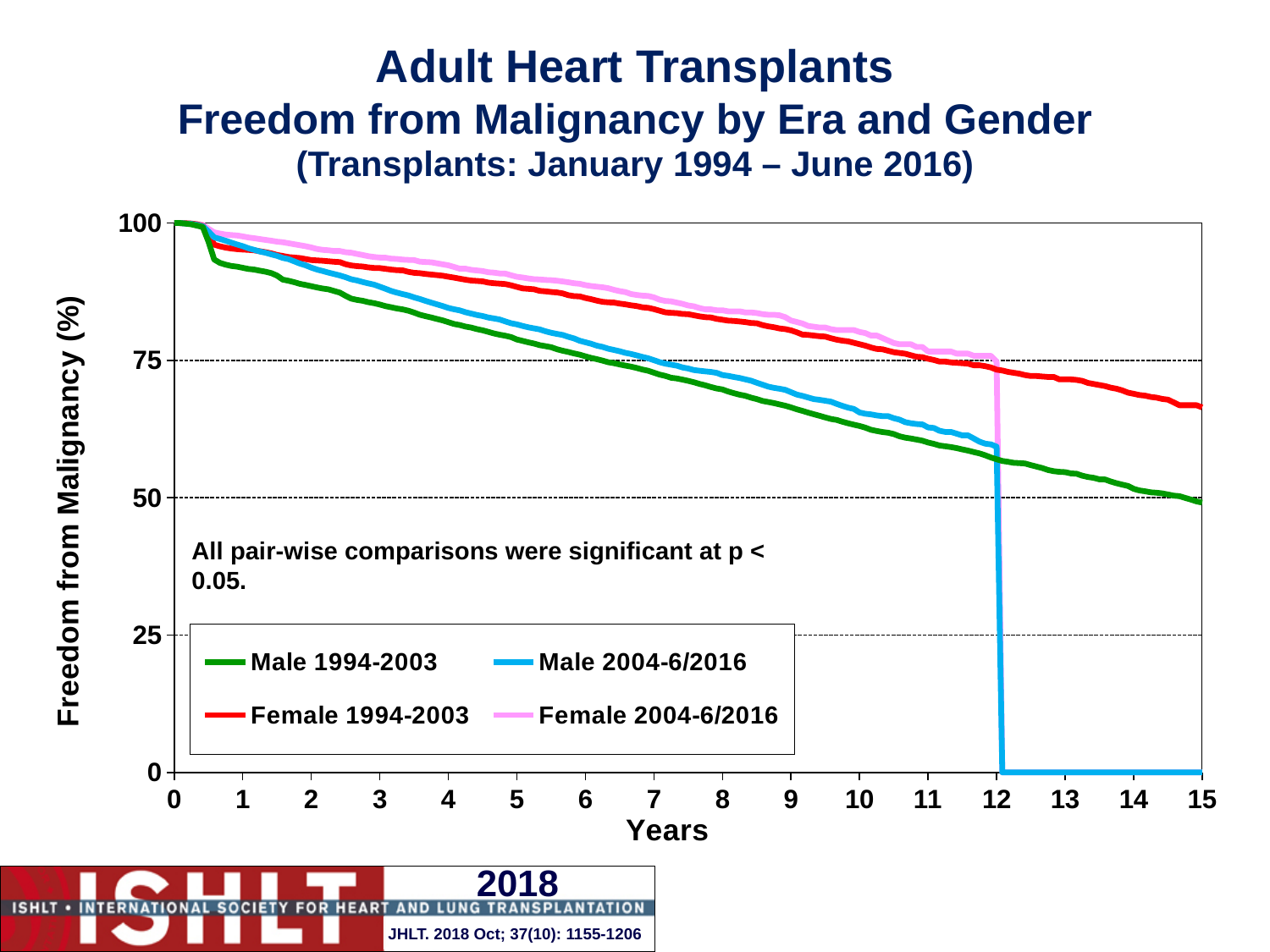
Is the value for Male 1994-2003 at 10 years greater or less than 75? less At 10 years, which is higher: Female 1994-2003 or Male 1994-2003? Female 1994-2003 Is the value for Female 1994-2003 at 5 years greater or less than 75? greater What kind of chart is shown on the slide? line chart Which series has the lowest freedom from malignancy at 10 years? Male 1994-2003 At 5 years, which is higher: Female 2004-6/2016 or Male 2004-6/2016? Female 2004-6/2016 Is the value for Female 1994-2003 at 15 years greater or less than 50? greater What is the label of the y axis? Freedom from Malignancy (%) Does freedom from malignancy for Male 1994-2003 rise or fall as years increase? fall How many series does the legend list? 4